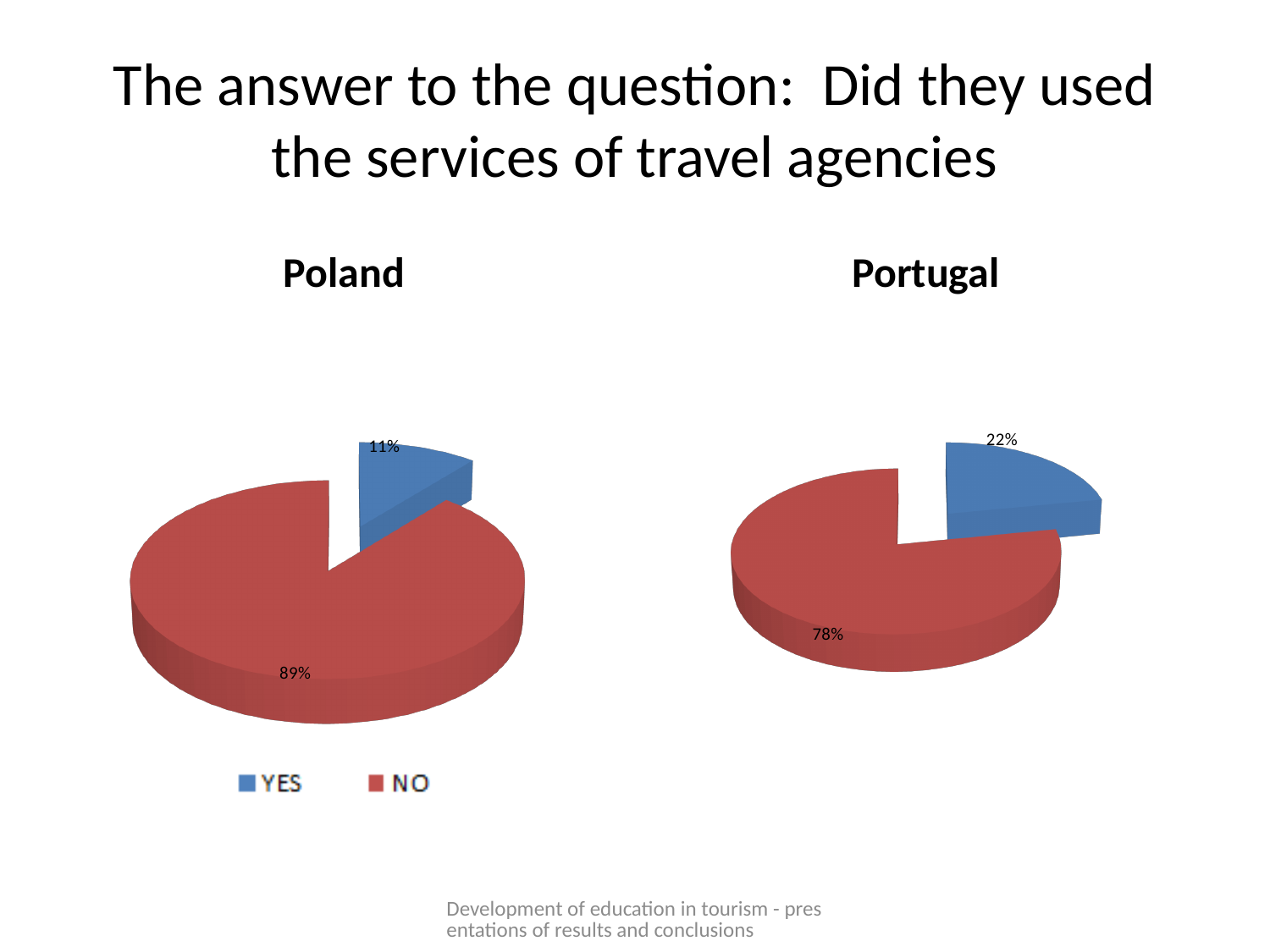
In the Portugal pie chart, which answer has the smallest share? YES Which country has the larger YES share, Poland or Portugal? Portugal In the Portugal pie chart, what percentage answered NO? 78% What colour represents NO in the legend? Red In the Poland pie chart, what percentage answered YES? 11% In the Poland pie chart, which answer has the largest share? NO What is the difference between the NO and YES shares in the Poland pie chart? 78% How many slices does the Portugal pie chart have? 2 In the Portugal pie chart, what percentage answered YES? 22% What type of chart is used for Poland and Portugal on this slide? Pie chart In the Poland pie chart, what percentage answered NO? 89% How many entries does the legend list? 2